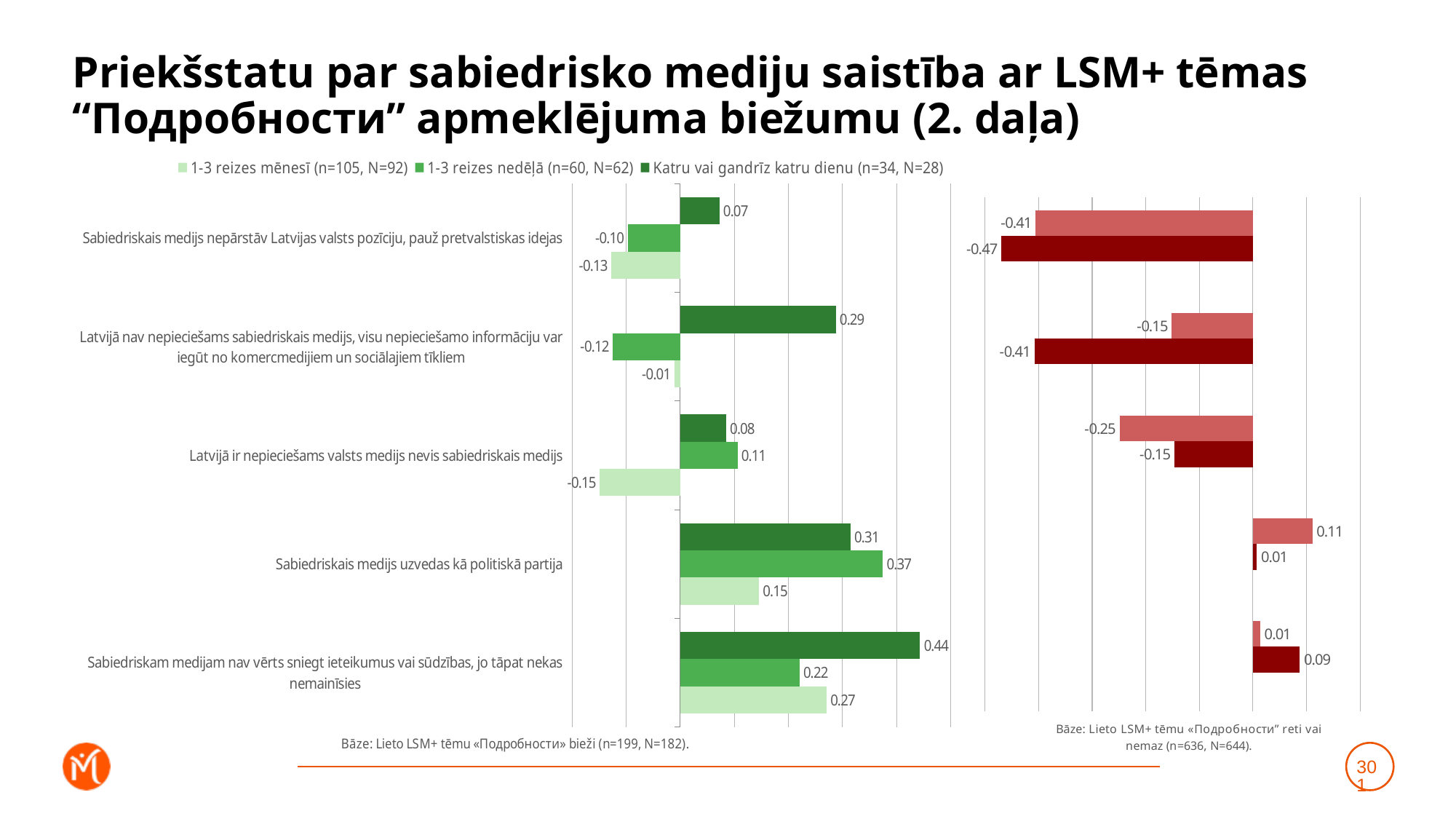
How many statements (categories) are shown in the left (green) chart? 5 In the left (green) chart, what is the difference between the 'Katru vai gandrīz katru dienu' value (0.29) and the '1-3 reizes nedēļā' value (-0.12) for 'Latvijā nav nepieciešams sabiedriskais medijs, visu nepieciešamo informāciju var iegūt no komercmedijiem un sociālajiem tīkliem'? 0.41 In the left (green) chart, which statement has the lowest value for '1-3 reizes mēnesī'? Latvijā ir nepieciešams valsts medijs nevis sabiedriskais medijs In the right (red) chart, what is the lowest value printed for the statement 'Sabiedriskais medijs nepārstāv Latvijas valsts pozīciju, pauž pretvalstiskas idejas'? -0.47 In the left (green) chart, what is the value for 'Katru vai gandrīz katru dienu' for the statement 'Sabiedriskam medijam nav vērts sniegt ieteikumus vai sūdzības, jo tāpat nekas nemainīsies'? 0.44 According to the legend of the left (green) chart, what is the sample size shown for 'Katru vai gandrīz katru dienu'? n=34, N=28 In the left (green) chart, which statement has the highest value for 'Katru vai gandrīz katru dienu'? Sabiedriskam medijam nav vērts sniegt ieteikumus vai sūdzības, jo tāpat nekas nemainīsies How many series does the legend of the left (green) chart list? 3 In the left (green) chart, for 'Sabiedriskam medijam nav vērts sniegt ieteikumus vai sūdzības, jo tāpat nekas nemainīsies', which is larger: the '1-3 reizes mēnesī' value or the '1-3 reizes nedēļā' value? 1-3 reizes mēnesī In the left (green) chart, what is the value for '1-3 reizes nedēļā' for the statement 'Sabiedriskais medijs uzvedas kā politiskā partija'? 0.37 In the left (green) chart, what is the value for '1-3 reizes mēnesī' for the statement 'Latvijā ir nepieciešams valsts medijs nevis sabiedriskais medijs'? -0.15 What kind of chart is the left (green) chart? Bar chart